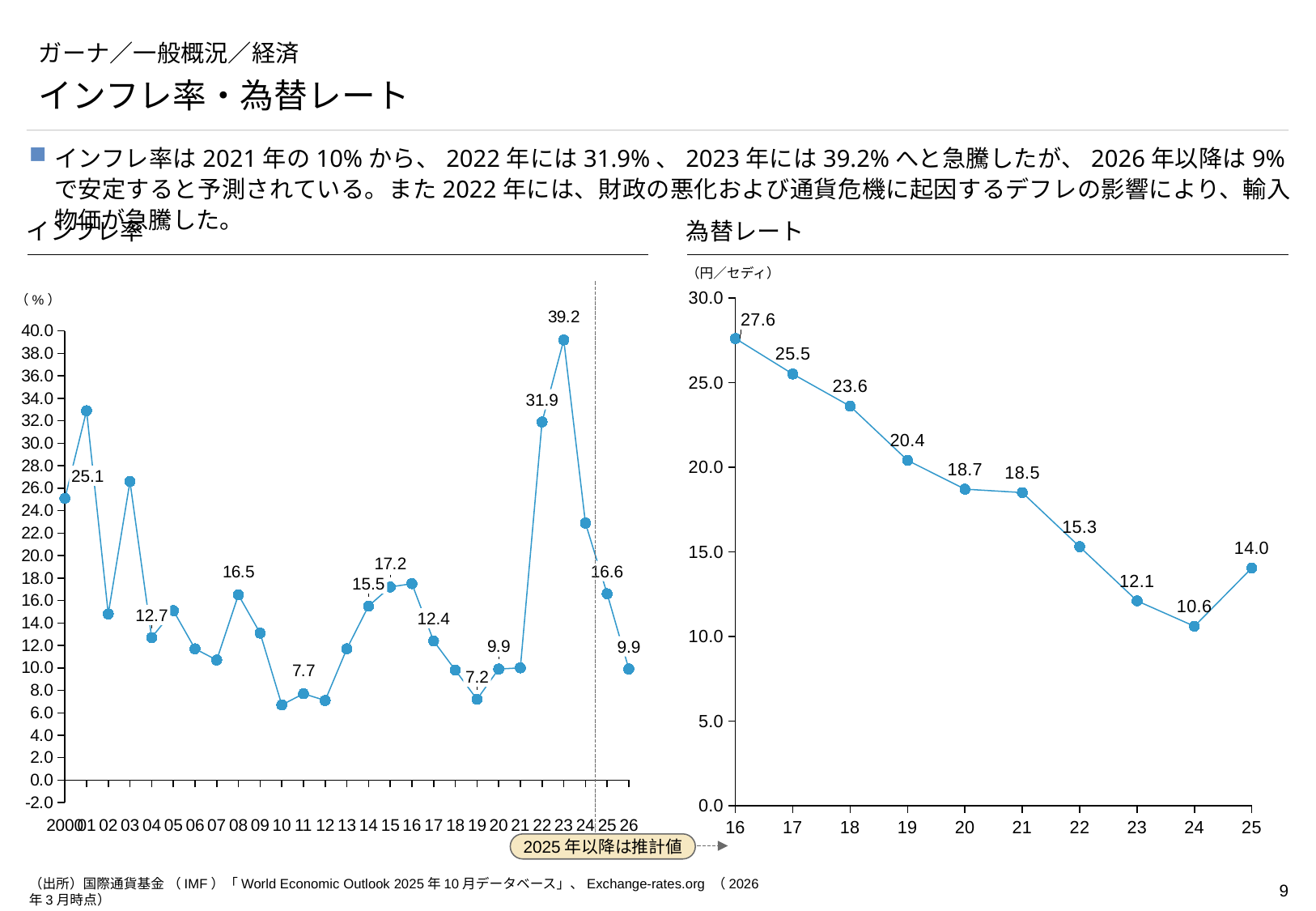
In the 為替レート chart, which year has the highest value? 16 How many data points are plotted in the 為替レート chart? 10 In the 為替レート chart, what is the value for 16? 27.6 In the 為替レート chart, which year has the lowest value? 24 In the インフレ率 chart, which year has the highest inflation rate? 2023 In the 為替レート chart, what is the value for 24? 10.6 In the 為替レート chart, what is the difference between the value for 16 and the value for 25? 13.6 In the インフレ率 chart, what is the value labelled for 2022? 31.9 In the インフレ率 chart, what is the difference between the 2023 value and the 2022 value? 7.3 What kind of chart is the 為替レート chart? line chart In the インフレ率 chart, is the value for 2024 greater or less than 20.0? greater In the インフレ率 chart, what is the inflation rate value labelled for 2023? 39.2